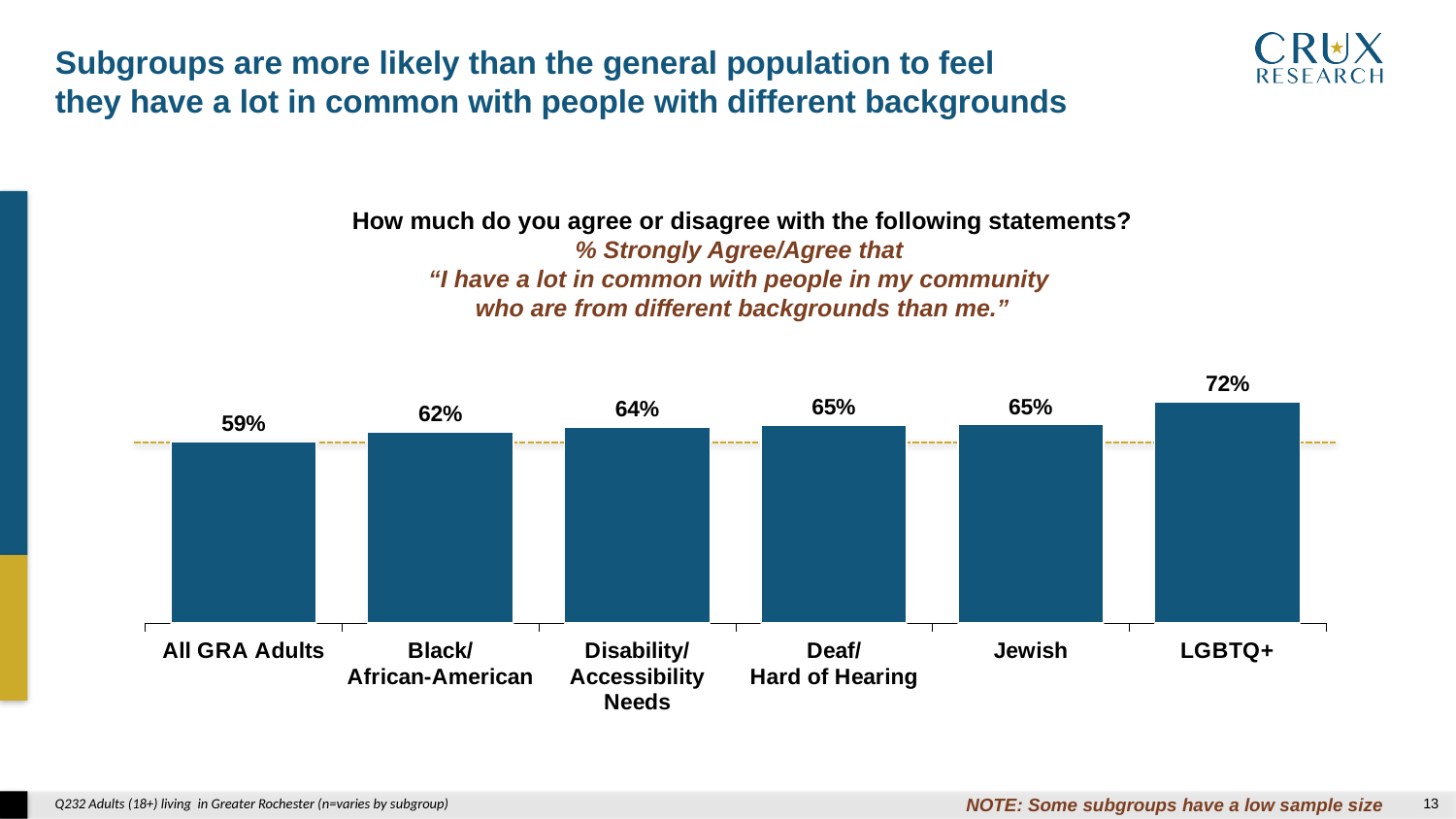
What is the value shown for the LGBTQ+ subgroup? 72% What percentage of All GRA Adults strongly agree/agree that they have a lot in common with people from different backgrounds? 59% What is the value shown for the Disability/Accessibility Needs subgroup? 64% What kind of chart is shown on the slide? Bar chart What is the value shown for the Black/African-American subgroup? 62% Which category has the lowest percentage agreeing with the statement? All GRA Adults Do the values generally rise or fall moving from left to right across the chart? Rise How many categories are shown in the chart? 6 What is the difference in percentage points between LGBTQ+ and All GRA Adults? 13 What is the difference in percentage points between Jewish and Black/African-American? 3 Which is larger, the value for Deaf/Hard of Hearing or the value for Black/African-American? Deaf/Hard of Hearing Which subgroup has the highest percentage agreeing with the statement? LGBTQ+